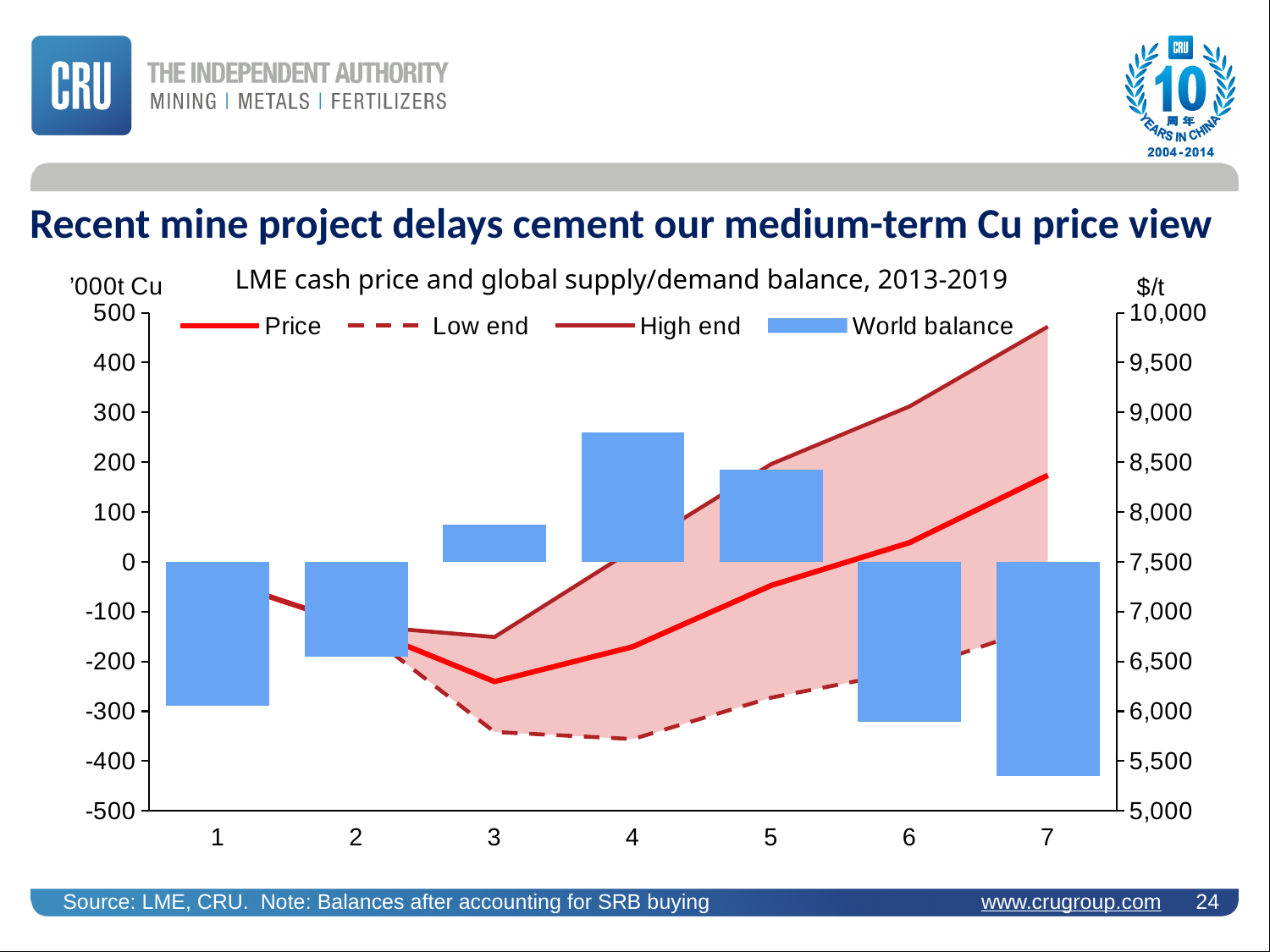
Which category has the lowest World balance bar? 7 How many series does the chart legend list? 4 Is the Price value for category 7 greater or less than 8,000? greater Which category has the highest World balance bar? 4 Does the Price line rise or fall from category 3 to category 7? rise How many categories are shown on the x axis? 7 Is the World balance value for category 7 greater or less than -400? less What is the title of the chart? LME cash price and global supply/demand balance, 2013-2019 Which has the larger World balance, category 4 or category 5? 4 What kind of chart is this? Combined bar and line chart Is the Low end value for category 4 greater or less than 6,000? less